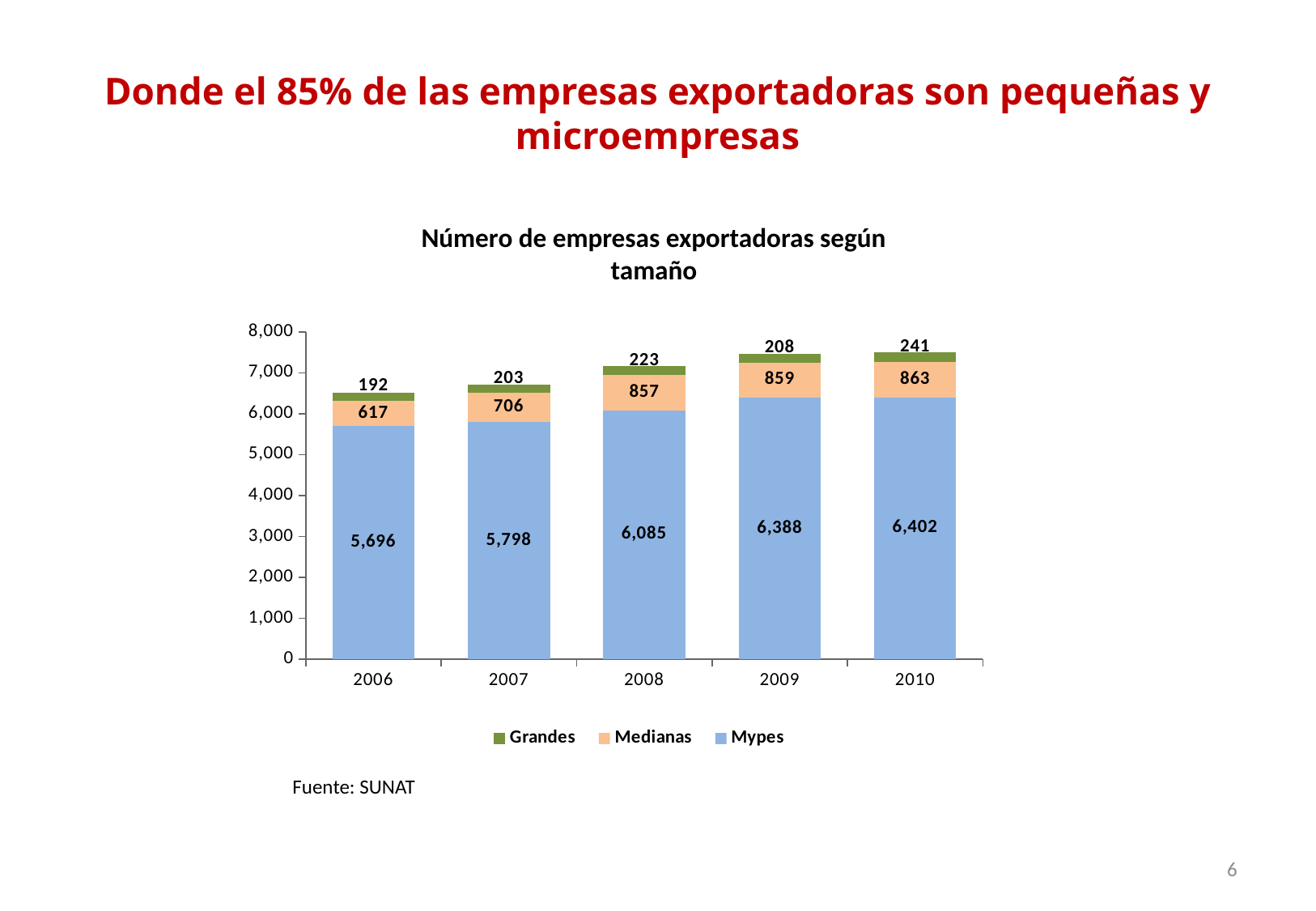
Which is larger, the Grandes value in 2008 or in 2009? 2008 What is the total of the stacked bar for 2010? 7,506 What is the value for Grandes in 2010? 241 What kind of chart is shown? Stacked bar chart What is the total of the stacked bar for 2006? 6,505 How many years are shown on the x axis? 5 How many series does the legend list? 3 In which year is the Grandes value lowest? 2006 What is the difference between the Mypes value in 2010 and in 2006? 706 What is the value for Medianas in 2007? 706 What is the value for Mypes in 2008? 6,085 In which year is the Mypes value highest? 2010